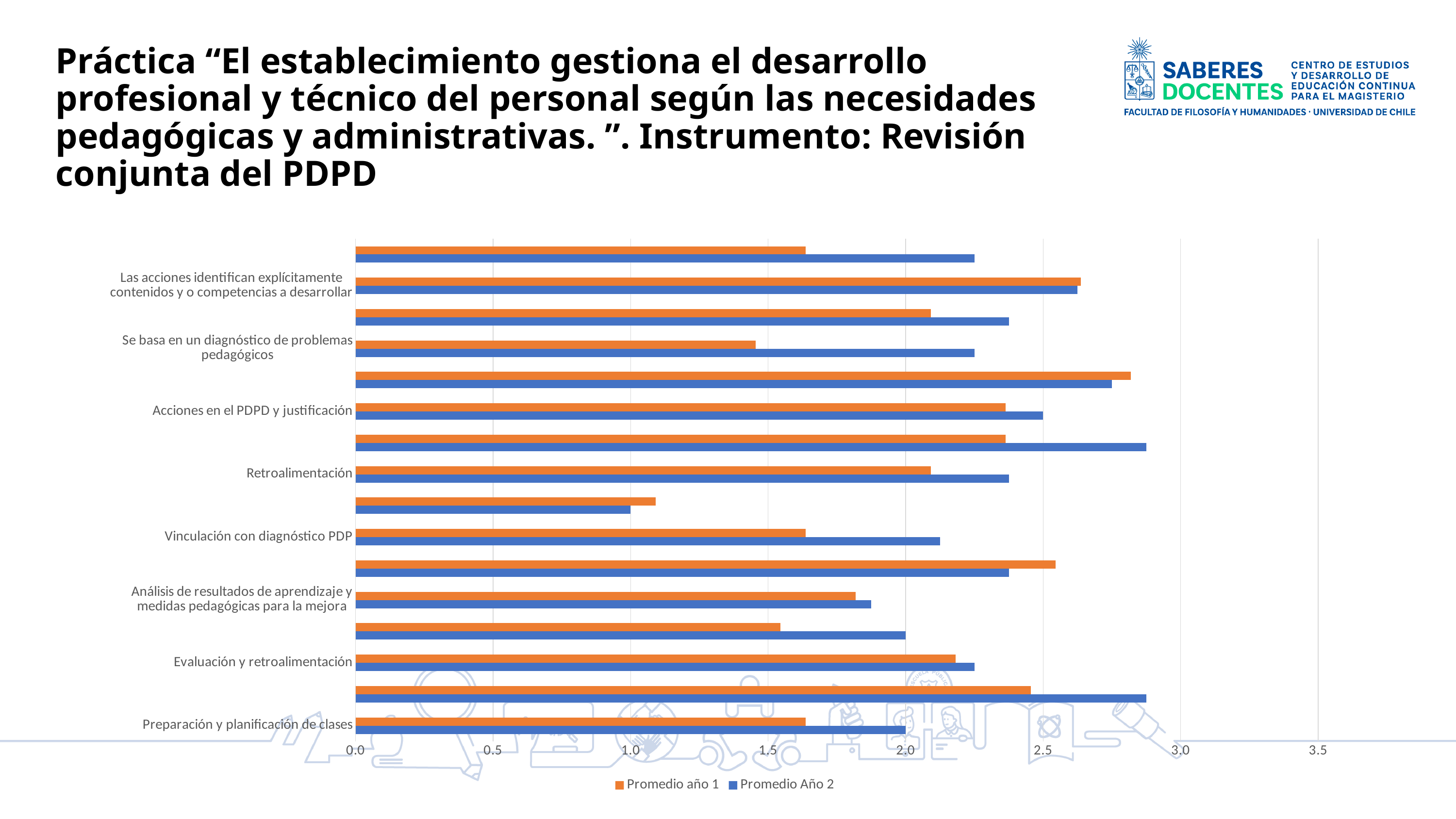
How many category labels are shown on the vertical axis? 8 Is the Promedio año 1 value for 'Las acciones identifican explícitamente contenidos y o competencias a desarrollar' greater or less than 2.5? greater For 'Preparación y planificación de clases', which series has the larger value, Promedio año 1 or Promedio Año 2? Promedio Año 2 How many series does the legend list? 2 Is the Promedio año 1 value for 'Vinculación con diagnóstico PDP' greater or less than 1.5? greater Is the Promedio Año 2 value for 'Análisis de resultados de aprendizaje y medidas pedagógicas para la mejora' greater or less than 2.0? less For 'Vinculación con diagnóstico PDP', which series has the larger value, Promedio año 1 or Promedio Año 2? Promedio Año 2 Which colour represents Promedio Año 2? blue For 'Se basa en un diagnóstico de problemas pedagógicos', which series has the larger value, Promedio año 1 or Promedio Año 2? Promedio Año 2 What are the two series named in the legend? Promedio año 1 and Promedio Año 2 What kind of chart is shown on the slide? bar chart